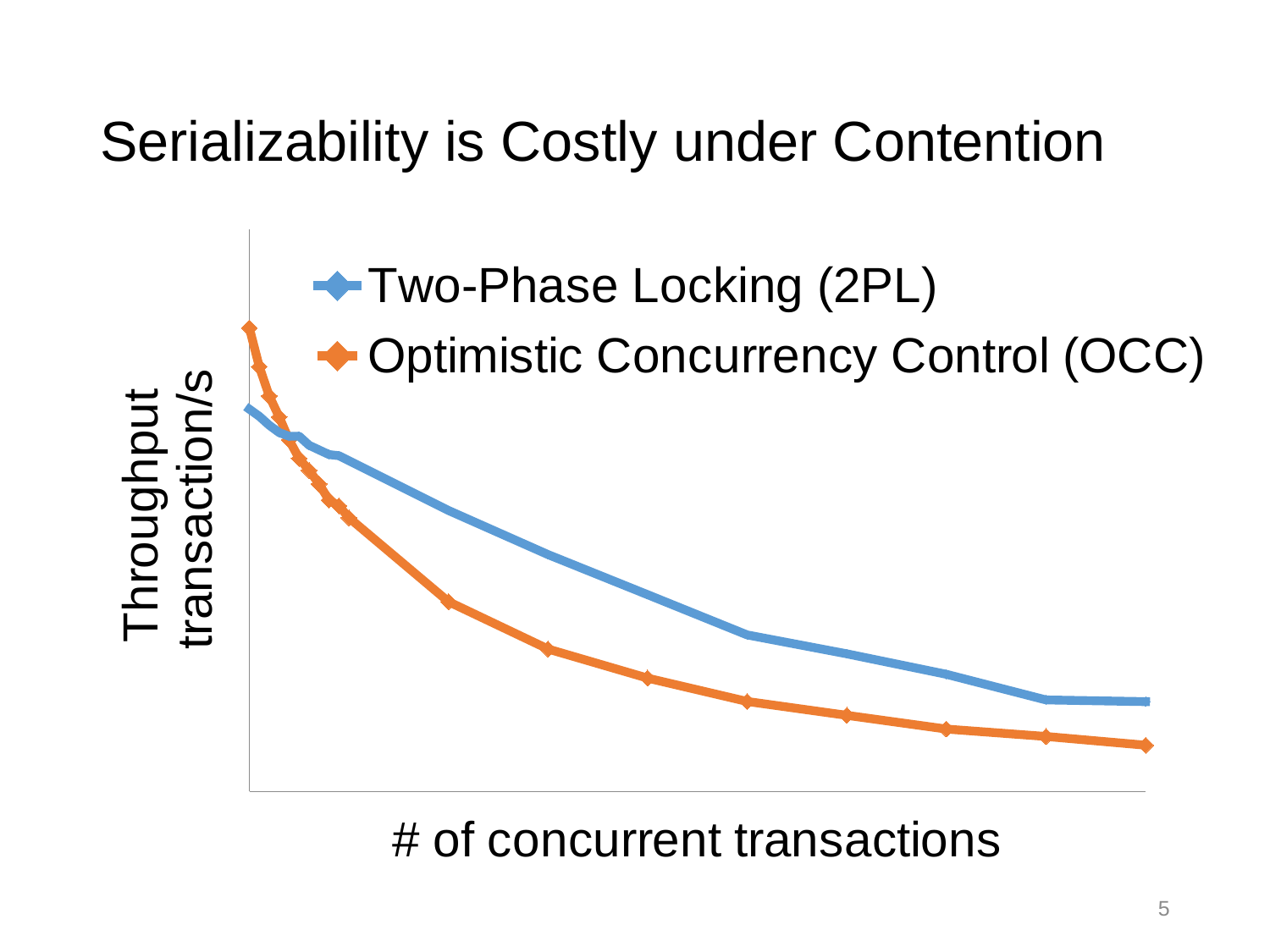
Does the throughput of Optimistic Concurrency Control (OCC) rise or fall as the number of concurrent transactions increases? fall Which series is drawn in orange? Optimistic Concurrency Control (OCC) At the left end of the x axis (lowest number of concurrent transactions), which series has the higher throughput? Optimistic Concurrency Control (OCC) At the right end of the x axis (highest number of concurrent transactions), which series has the higher throughput? Two-Phase Locking (2PL) What are the two series named in the legend? Two-Phase Locking (2PL) and Optimistic Concurrency Control (OCC) Which series reaches the highest throughput value anywhere on the chart? Optimistic Concurrency Control (OCC) Does the throughput of Two-Phase Locking (2PL) rise or fall as the number of concurrent transactions increases? fall Which series has the lowest throughput value anywhere on the chart? Optimistic Concurrency Control (OCC) What kind of chart is shown on the slide? line chart How many series does the legend list? 2 What is the label of the x axis? # of concurrent transactions